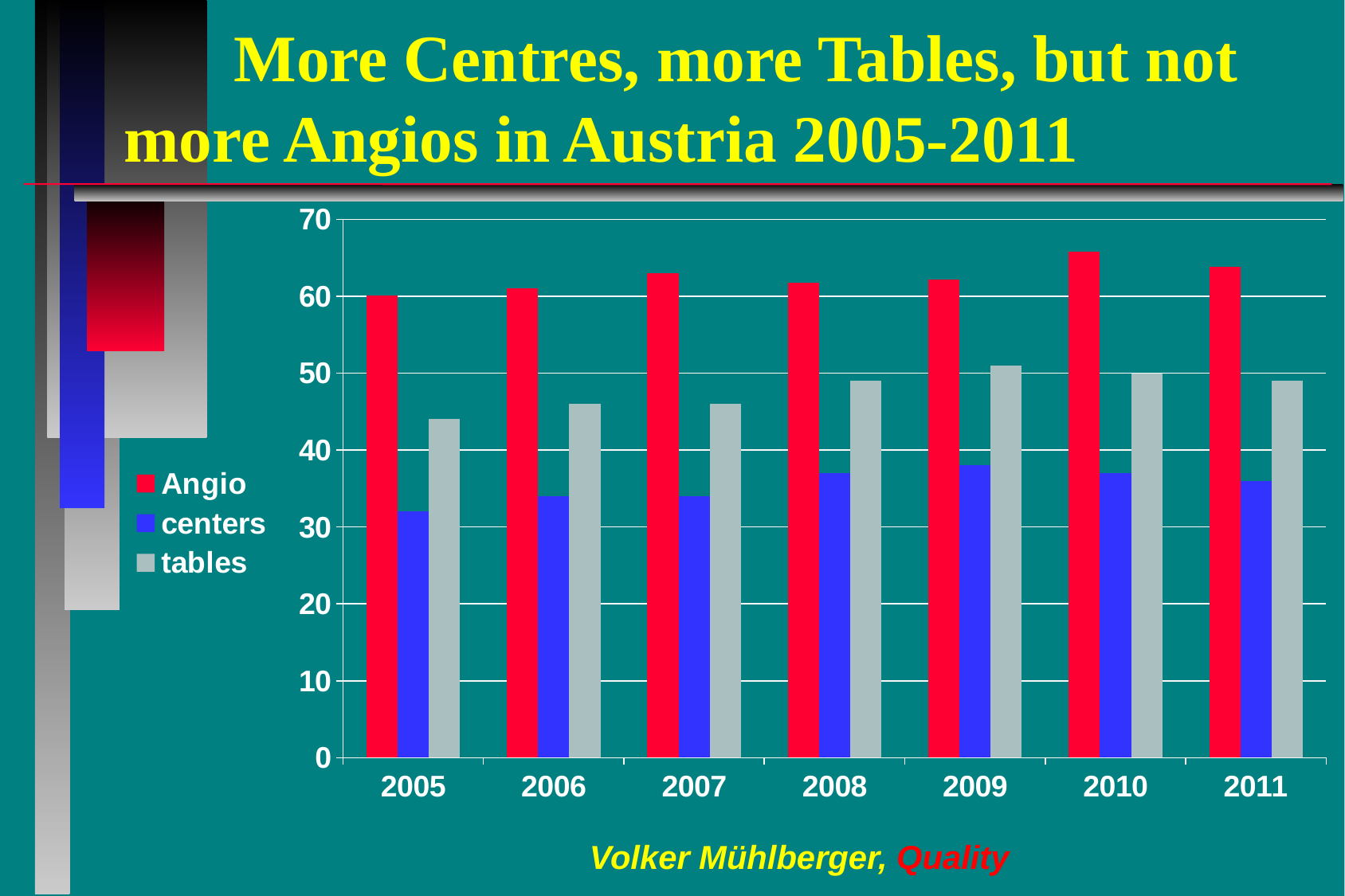
In which year is the Angio bar the highest? 2010 How many years are shown on the x axis of the chart? 7 What kind of chart is shown on the slide? bar chart How many series does the chart's legend list? 3 Is the Angio value for 2005 greater or less than 50? greater Is the centers value for 2005 greater or less than 40? less Is the tables value for 2006 greater or less than 50? less In 2010, which is larger: the Angio value or the tables value? Angio In 2005, which is larger: the centers value or the tables value? tables What colour are the Angio bars in the chart? red In which year is the tables bar the lowest? 2005